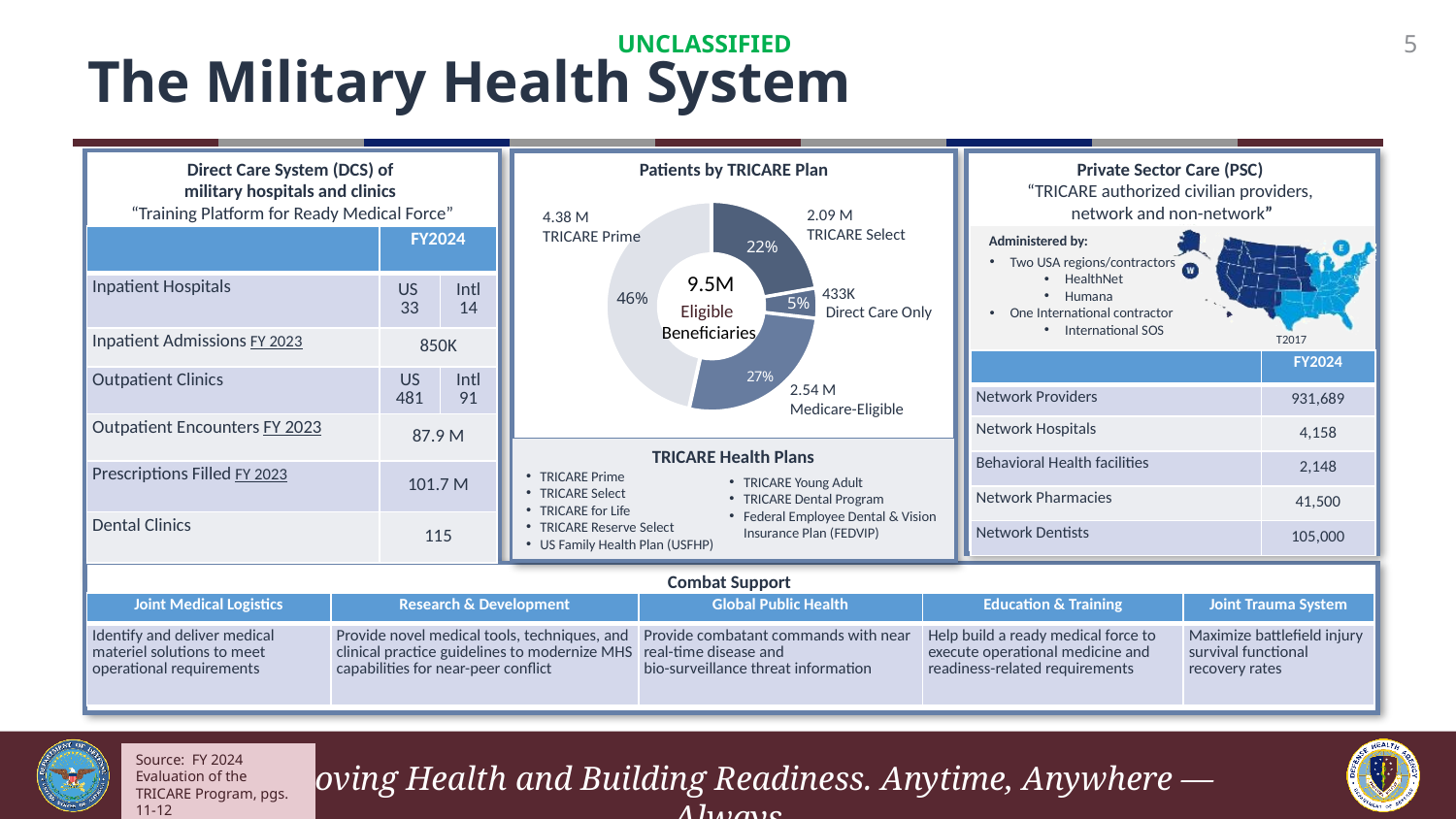
In the "Patients by TRICARE Plan" chart, what percentage share does TRICARE Prime have? 46% In the "Patients by TRICARE Plan" chart, which plan category has the smallest share? Direct Care Only In the "Patients by TRICARE Plan" chart, how many patients are Direct Care Only? 433K In the "Patients by TRICARE Plan" chart, what percentage share does Direct Care Only have? 5% What total number of eligible beneficiaries is shown in the center of the "Patients by TRICARE Plan" chart? 9.5M In the "Patients by TRICARE Plan" chart, what percentage share does Medicare-Eligible have? 27% In the "Patients by TRICARE Plan" chart, how many plan categories are shown? 4 In the "Patients by TRICARE Plan" chart, how many patients are in TRICARE Prime? 4.38 M In the "Patients by TRICARE Plan" chart, how many patients are Medicare-Eligible? 2.54 M In the "Patients by TRICARE Plan" chart, which plan category has the largest share? TRICARE Prime In the "Patients by TRICARE Plan" chart, how many patients are in TRICARE Select? 2.09 M What kind of chart is used for "Patients by TRICARE Plan"? Donut (pie) chart